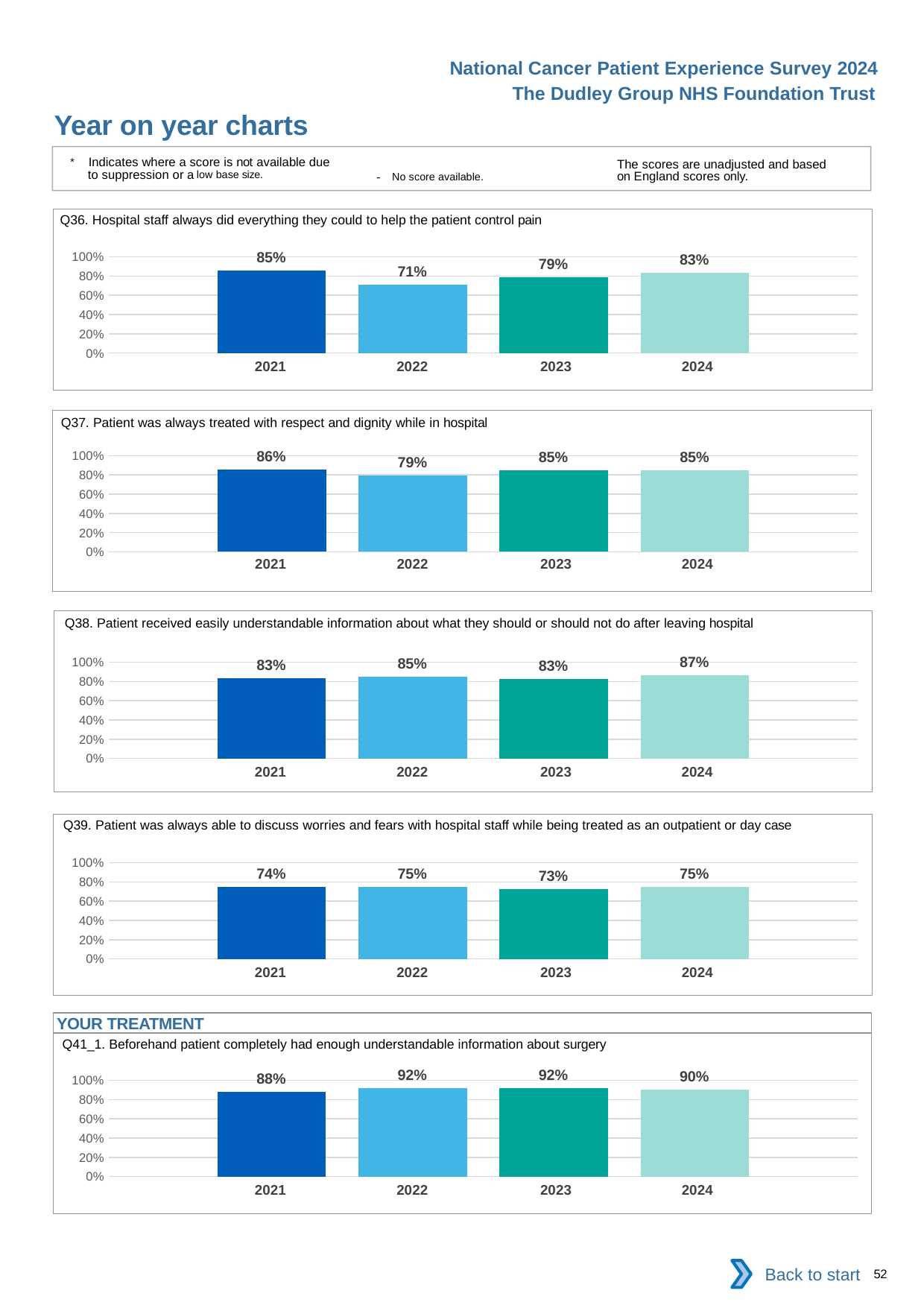
In the Q36 chart (hospital staff did everything to help control pain), what is the value for 2022? 71% In the Q39 chart (discuss worries and fears as an outpatient), what is the value for 2023? 73% In the Q38 chart (understandable information after leaving hospital), what is the value for 2024? 87% In the Q41_1 chart, what is the difference between the 2023 value and the 2024 value? 2 percentage points In the Q39 chart, is the value for 2021 greater or less than 80%? less In the Q37 chart (treated with respect and dignity), which year has the lowest value? 2022 What type of chart is used for Q37? Bar chart In the Q37 chart, what is the difference between the 2021 value and the 2022 value? 7 percentage points How many years are shown on the x axis of the Q36 chart? 4 In the Q38 chart, which is larger, the value for 2022 or the value for 2023? 2022 In the Q41_1 chart (understandable information about surgery), what is the value for 2021? 88% In the Q36 chart, which year has the highest value? 2021